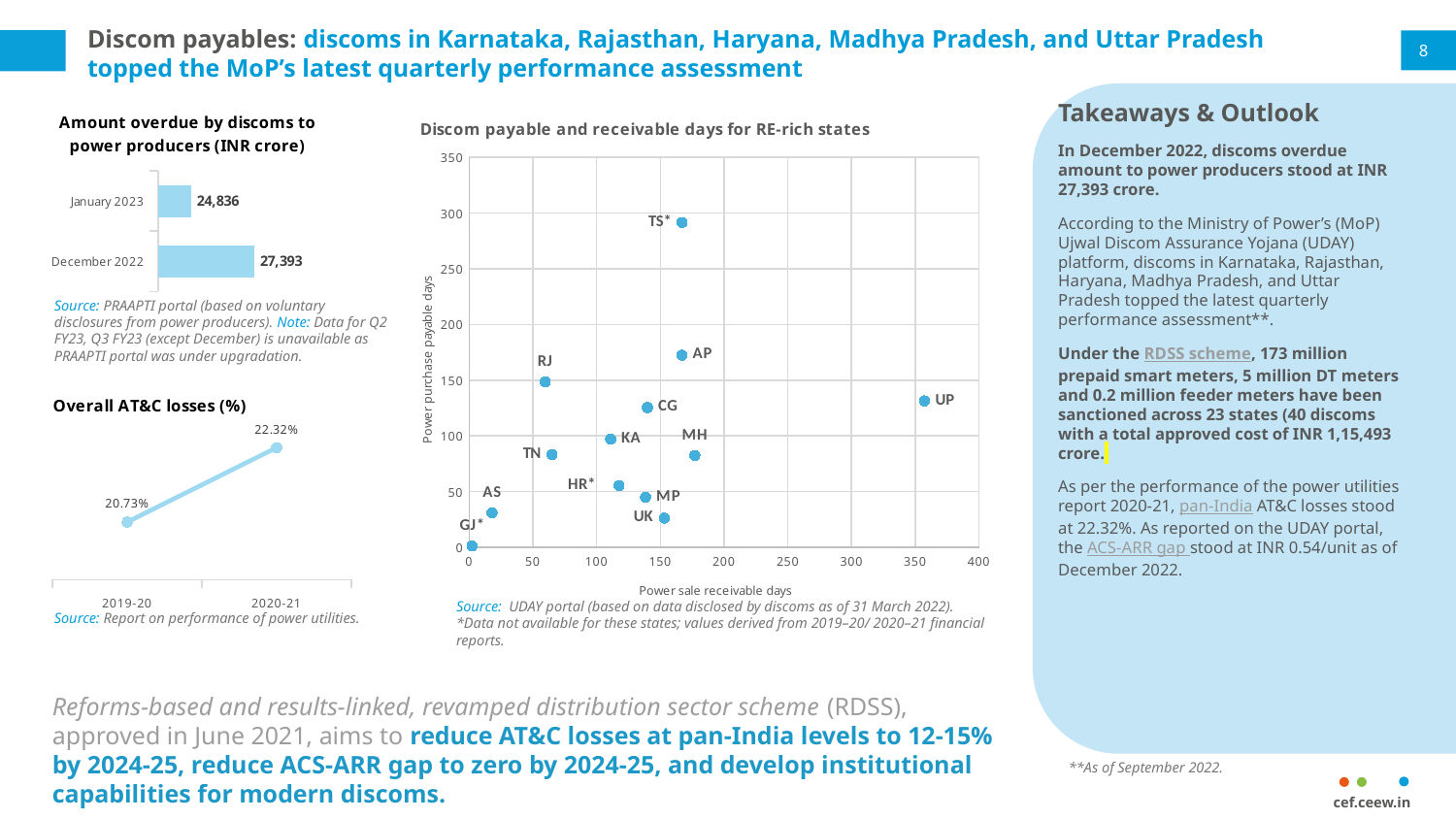
In the 'Discom payable and receivable days for RE-rich states' chart, which state has the highest power purchase payable days? TS* How many states are plotted in the 'Discom payable and receivable days for RE-rich states' chart? 13 In the 'Amount overdue by discoms to power producers (INR crore)' chart, what is the difference between the December 2022 and January 2023 values? 2,557 What type of chart is the 'Amount overdue by discoms to power producers (INR crore)' chart? Bar chart In the 'Amount overdue by discoms to power producers (INR crore)' chart, what is the value for January 2023? 24,836 In the 'Overall AT&C losses (%)' chart, what is the value for 2020-21? 22.32% In the 'Discom payable and receivable days for RE-rich states' chart, is the power purchase payable days value for TS* greater or less than 250? greater In the 'Overall AT&C losses (%)' chart, what is the value for 2019-20? 20.73% In the 'Amount overdue by discoms to power producers (INR crore)' chart, which period has the higher overdue amount? December 2022 In the 'Amount overdue by discoms to power producers (INR crore)' chart, what is the value for December 2022? 27,393 In the 'Discom payable and receivable days for RE-rich states' chart, is the power sale receivable days value for UP greater or less than 300? greater In the 'Overall AT&C losses (%)' chart, do the values rise or fall from 2019-20 to 2020-21? Rise